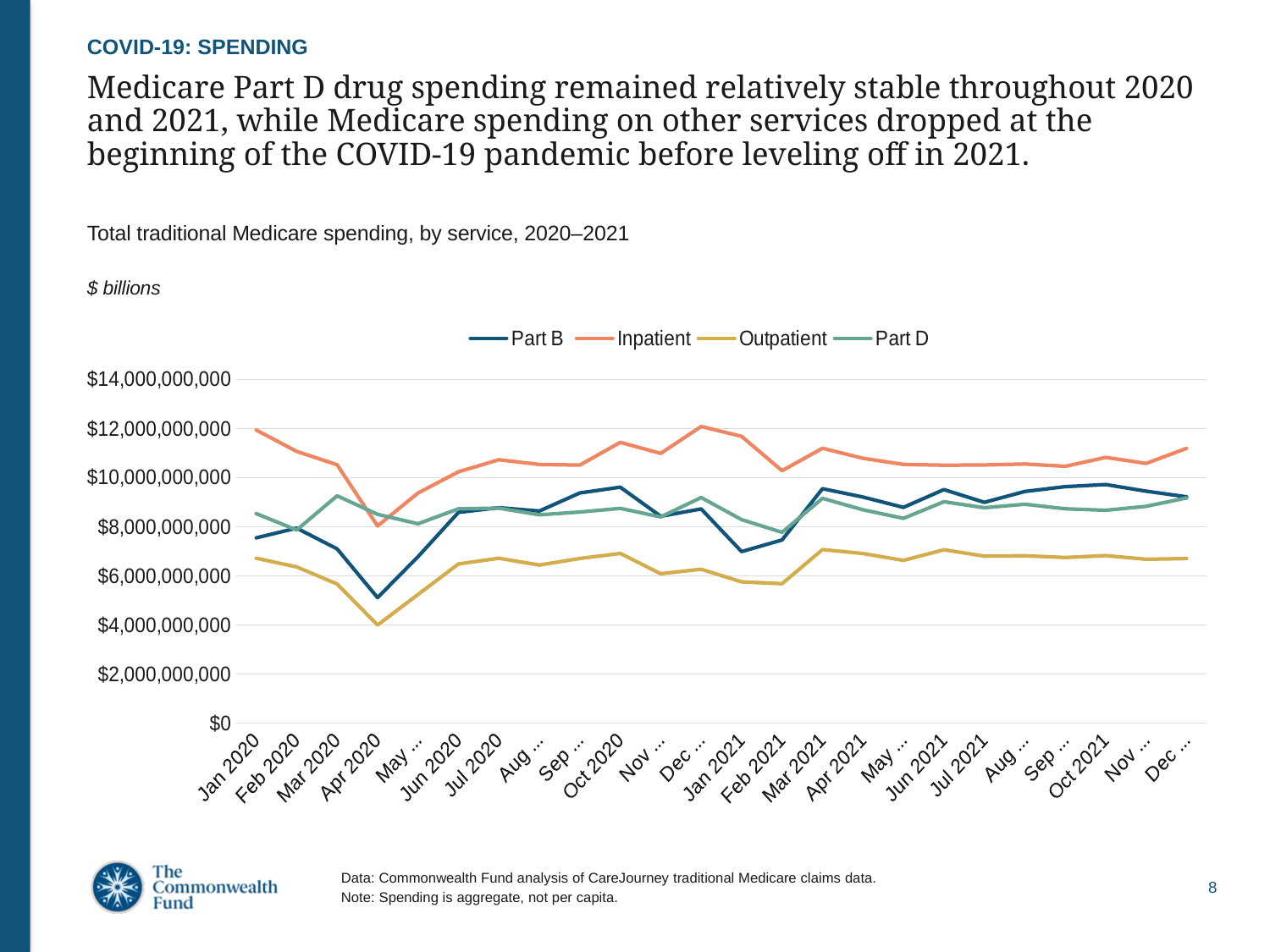
Is the Outpatient value for Apr 2020 greater or less than $6,000,000,000? less Which series has the lowest values across the whole period? Outpatient Does the Inpatient line rise or fall from Jan 2020 to Apr 2020? Fall Is the Inpatient value for Jul 2020 greater or less than $10,000,000,000? greater Is the Part B value for Apr 2020 greater or less than $6,000,000,000? less How many monthly points are plotted along the x axis? 24 What kind of chart is shown on the slide? Line chart Which series are listed in the legend? Part B, Inpatient, Outpatient, Part D What is the title of the chart? Total traditional Medicare spending, by service, 2020–2021 How many series does the legend list? 4 In Apr 2020, which is larger, Part B or Part D? Part D